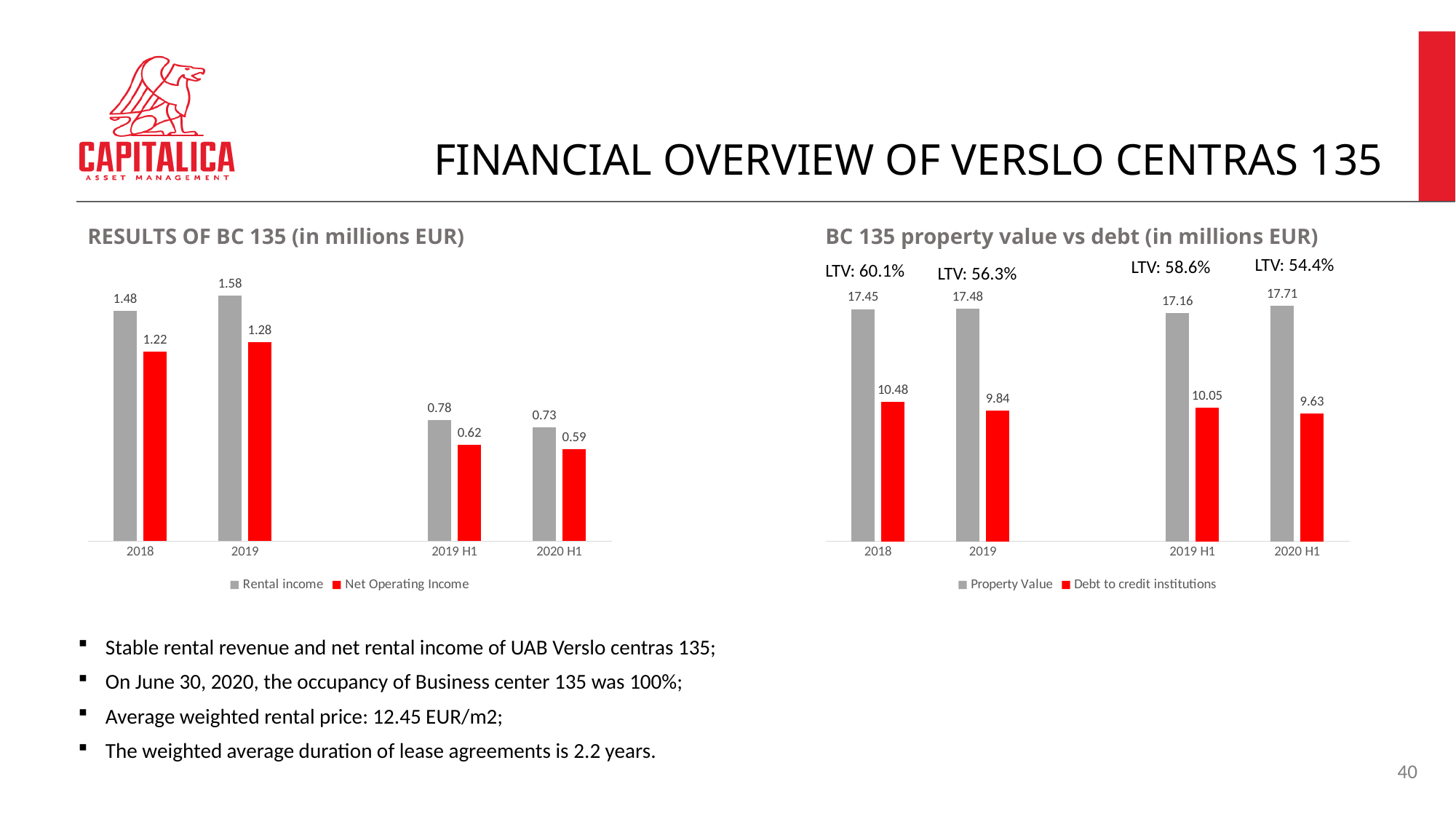
In the 'BC 135 property value vs debt (in millions EUR)' chart, what is the Property Value for 2020 H1? 17.71 In the 'BC 135 property value vs debt (in millions EUR)' chart, what is the Debt to credit institutions for 2019? 9.84 In the 'RESULTS OF BC 135 (in millions EUR)' chart, what is the difference between Rental income and Net Operating Income in 2018? 0.26 In the 'RESULTS OF BC 135 (in millions EUR)' chart, what is the Rental income for 2019? 1.58 In the 'BC 135 property value vs debt (in millions EUR)' chart, what is the difference between Property Value and Debt to credit institutions in 2019 H1? 7.11 In the 'RESULTS OF BC 135 (in millions EUR)' chart, which category has the highest Rental income? 2019 In the 'BC 135 property value vs debt (in millions EUR)' chart, how many categories are shown on the x axis? 4 What kind of chart is the 'RESULTS OF BC 135 (in millions EUR)' chart? Bar chart In the 'RESULTS OF BC 135 (in millions EUR)' chart, what is the Net Operating Income for 2020 H1? 0.59 In the 'BC 135 property value vs debt (in millions EUR)' chart, which category has the lowest Debt to credit institutions? 2020 H1 In the 'RESULTS OF BC 135 (in millions EUR)' chart, how many series does the legend list? 2 In the 'BC 135 property value vs debt (in millions EUR)' chart, what LTV is shown above the 2020 H1 bars? LTV: 54.4%